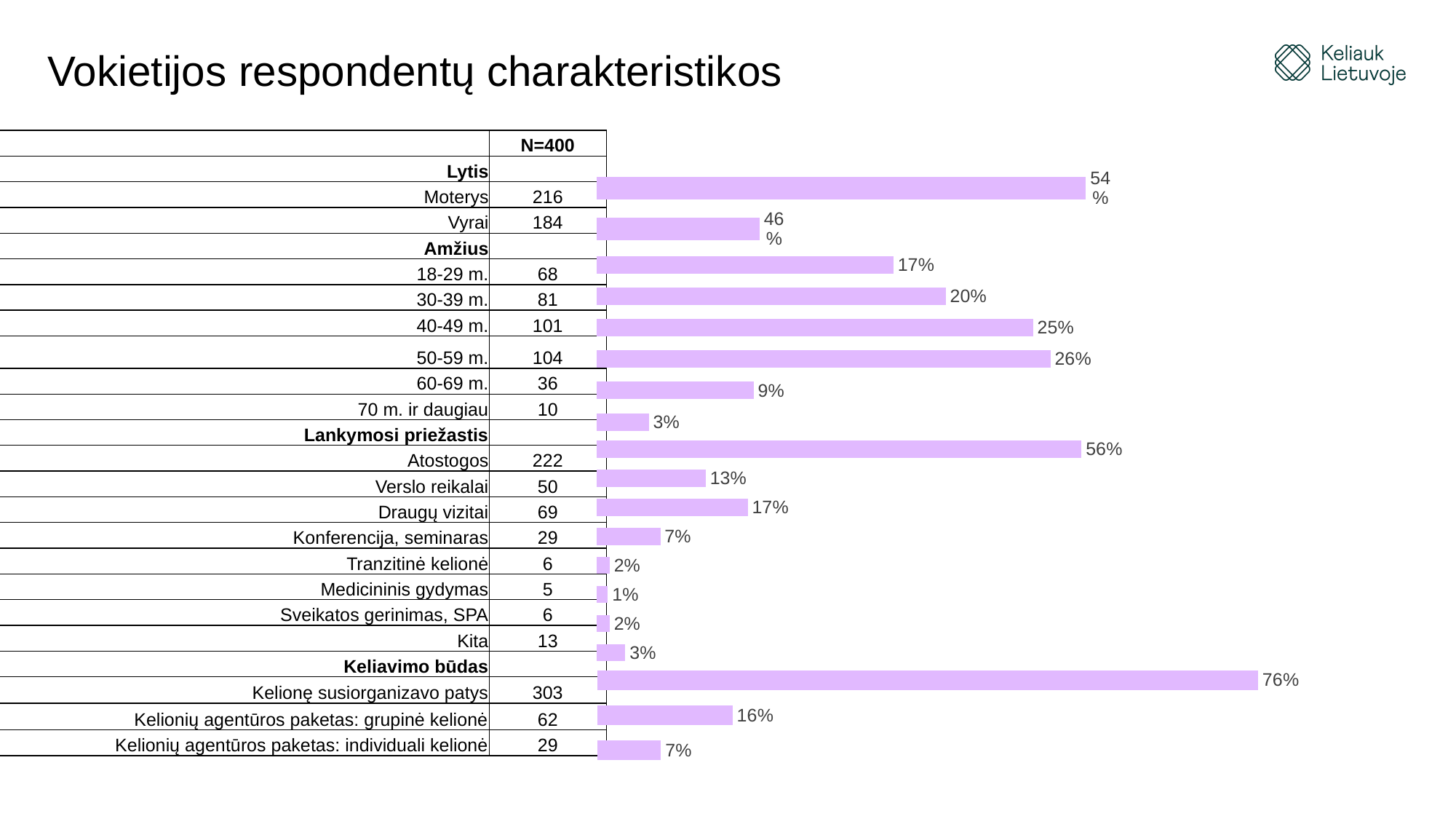
What percentage is shown for Atostogos? 56% Which category has the longest bar in the chart? Kelionę susiorganizavo patys What percentage is shown for Moterys? 54% What percentage is shown for the 50-59 m. age group? 26% What is the title of the slide? Vokietijos respondentų charakteristikos What type of chart is shown on the slide? Bar chart How many bars are plotted in the chart? 19 Which is larger, the percentage for Verslo reikalai or for Draugų vizitai? Draugų vizitai What is the difference in percentage points between Atostogos and Verslo reikalai? 43 What percentage is shown for Kelionę susiorganizavo patys? 76% What is the difference in percentage points between Moterys and Vyrai? 8 Which category has the shortest bar in the chart? Medicininis gydymas